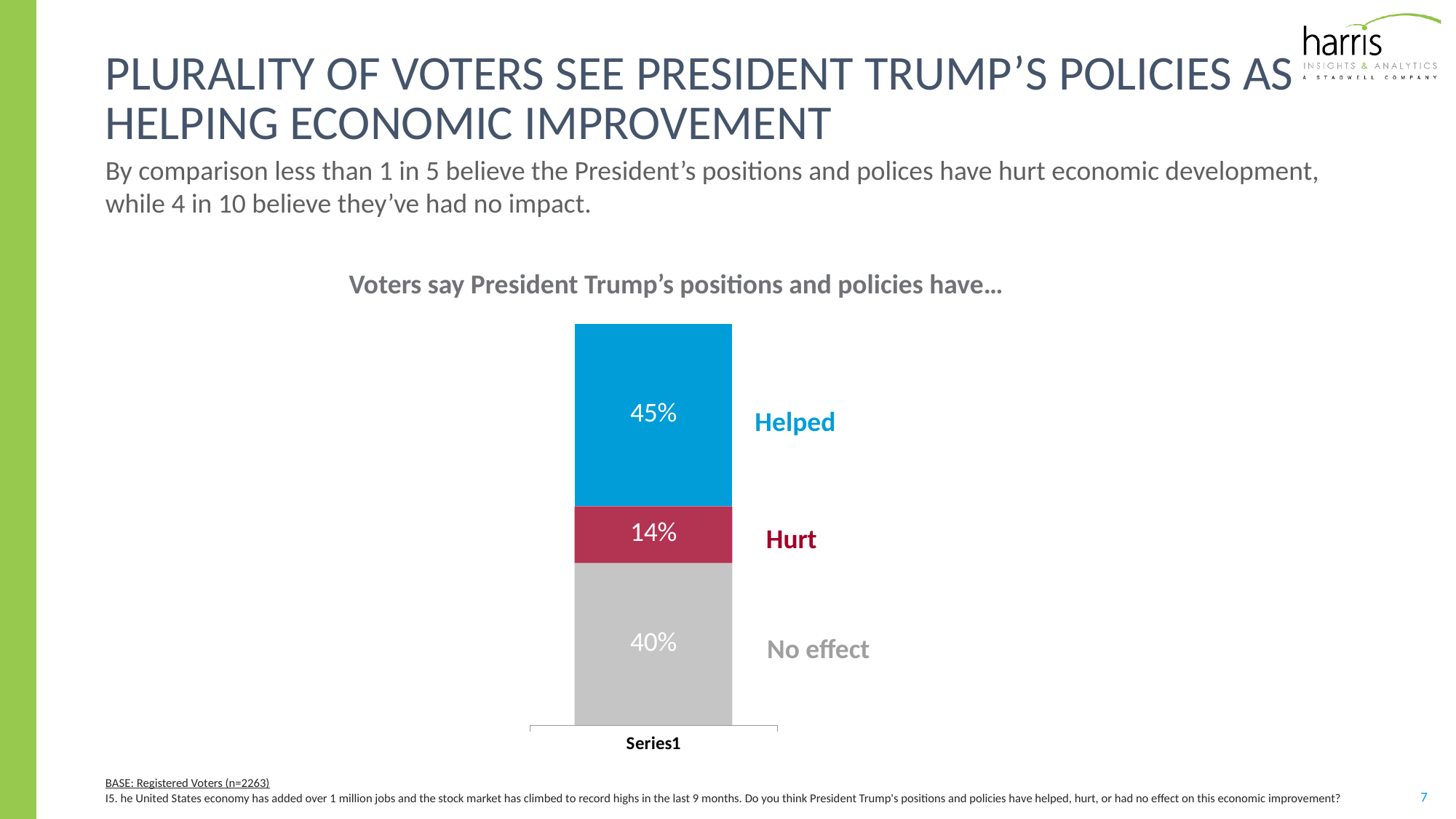
What percentage of voters say President Trump's positions and policies have helped? 45% Which is larger, the share saying No effect or the share saying Hurt? No effect Which response has the smallest share in the stacked bar? Hurt How many segments make up the stacked bar? 3 What is the title of the chart? Voters say President Trump's positions and policies have… What is the difference between the Helped and Hurt percentages? 31% What is the difference between the Helped and No effect percentages? 5% What type of chart is shown on the slide? Stacked bar chart What percentage of voters say President Trump's positions and policies have hurt? 14% What is the total of the three segments in the stacked bar? 99% Which response has the largest share in the stacked bar? Helped What percentage of voters say President Trump's positions and policies have had no effect? 40%